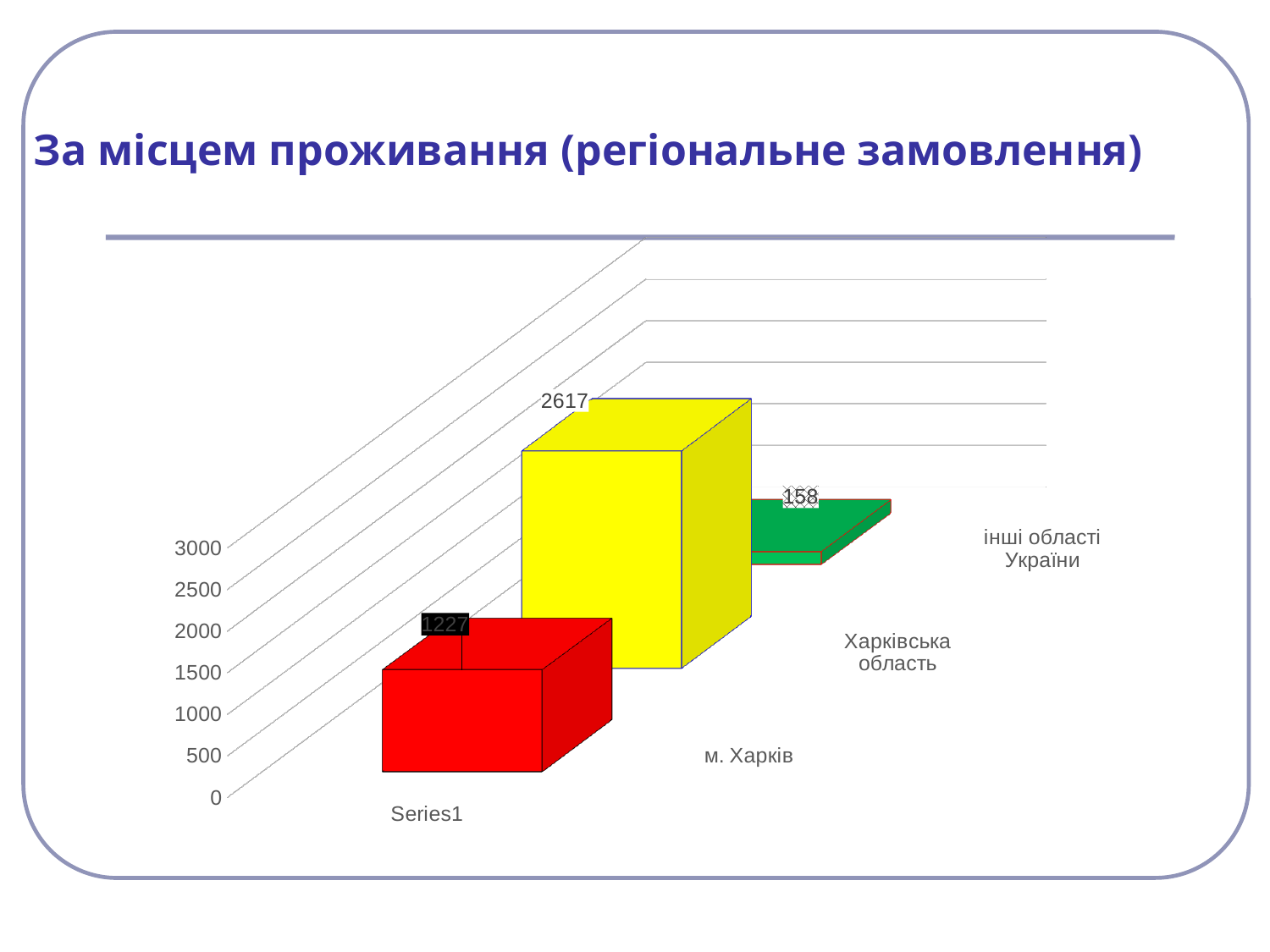
Is the value for Харківська область greater or less than 2500? greater Which category has the highest value? Харківська область Which is larger, the value for м. Харків or the value for інші області України? м. Харків What is the value for м. Харків? 1227 What is the title of the slide? За місцем проживання (регіональне замовлення) What kind of chart is shown on the slide? bar chart What is the value for інші області України? 158 What is the difference between the values for м. Харків and інші області України? 1069 What is the value for Харківська область? 2617 Which category has the lowest value? інші області України What is the difference between the values for Харківська область and м. Харків? 1390 How many categories are shown in the chart? 3